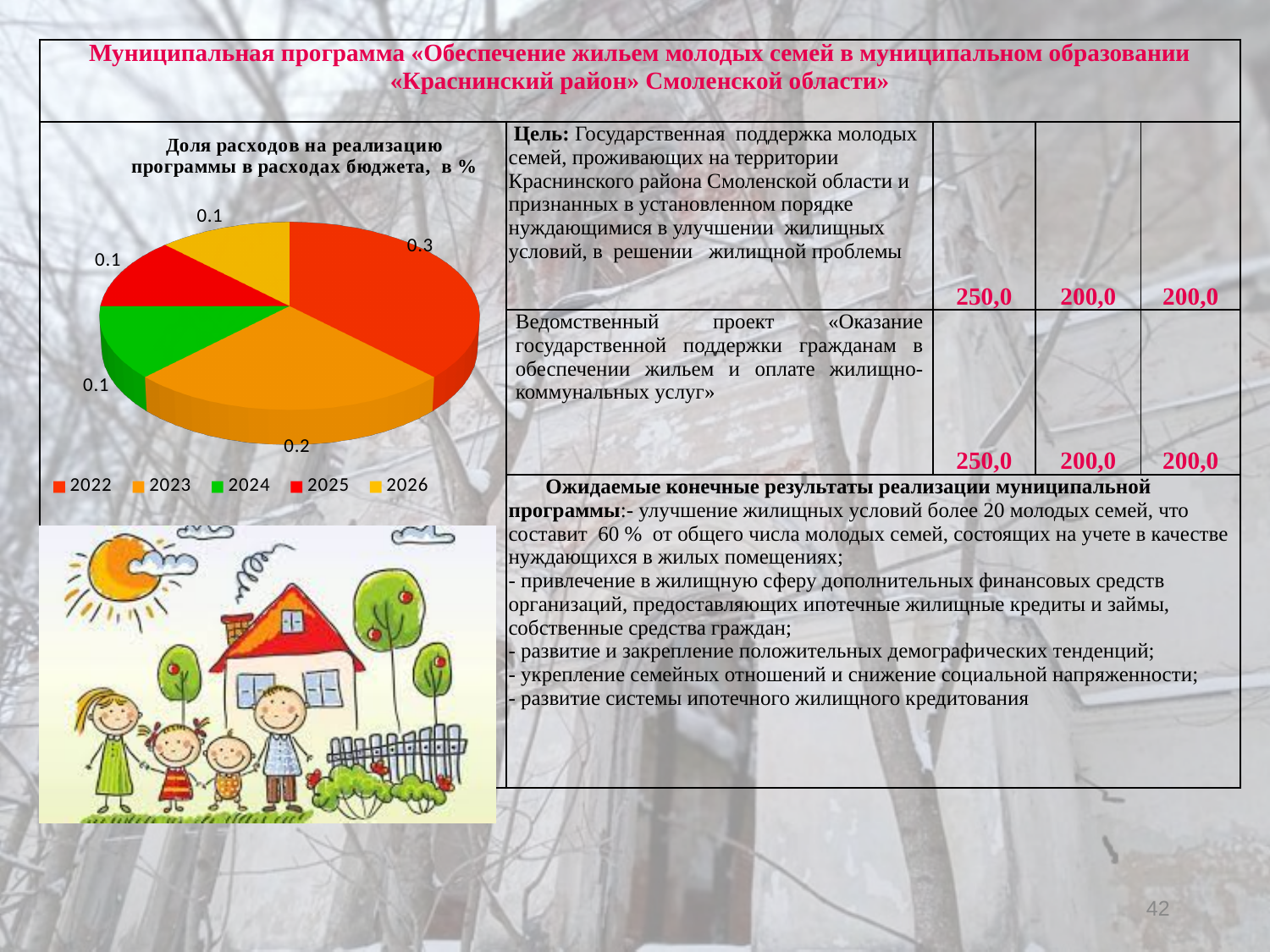
What is the value for 2022 in the pie chart? 0.3 How many entries does the legend of the pie chart list? 5 Which year has the largest slice in the pie chart? 2022 What is the difference between the values for 2022 and 2023 in the pie chart? 0.1 What is the title of the pie chart? Доля расходов на реализацию программы в расходах бюджета, в % Which is larger in the pie chart, the value for 2022 or the value for 2023? 2022 How many slices does the pie chart have? 5 What is the value for 2026 in the pie chart? 0.1 What is the value for 2024 in the pie chart? 0.1 Which is larger in the pie chart, the value for 2023 or the value for 2025? 2023 What type of chart is shown on the slide? Pie chart What is the value for 2023 in the pie chart? 0.2